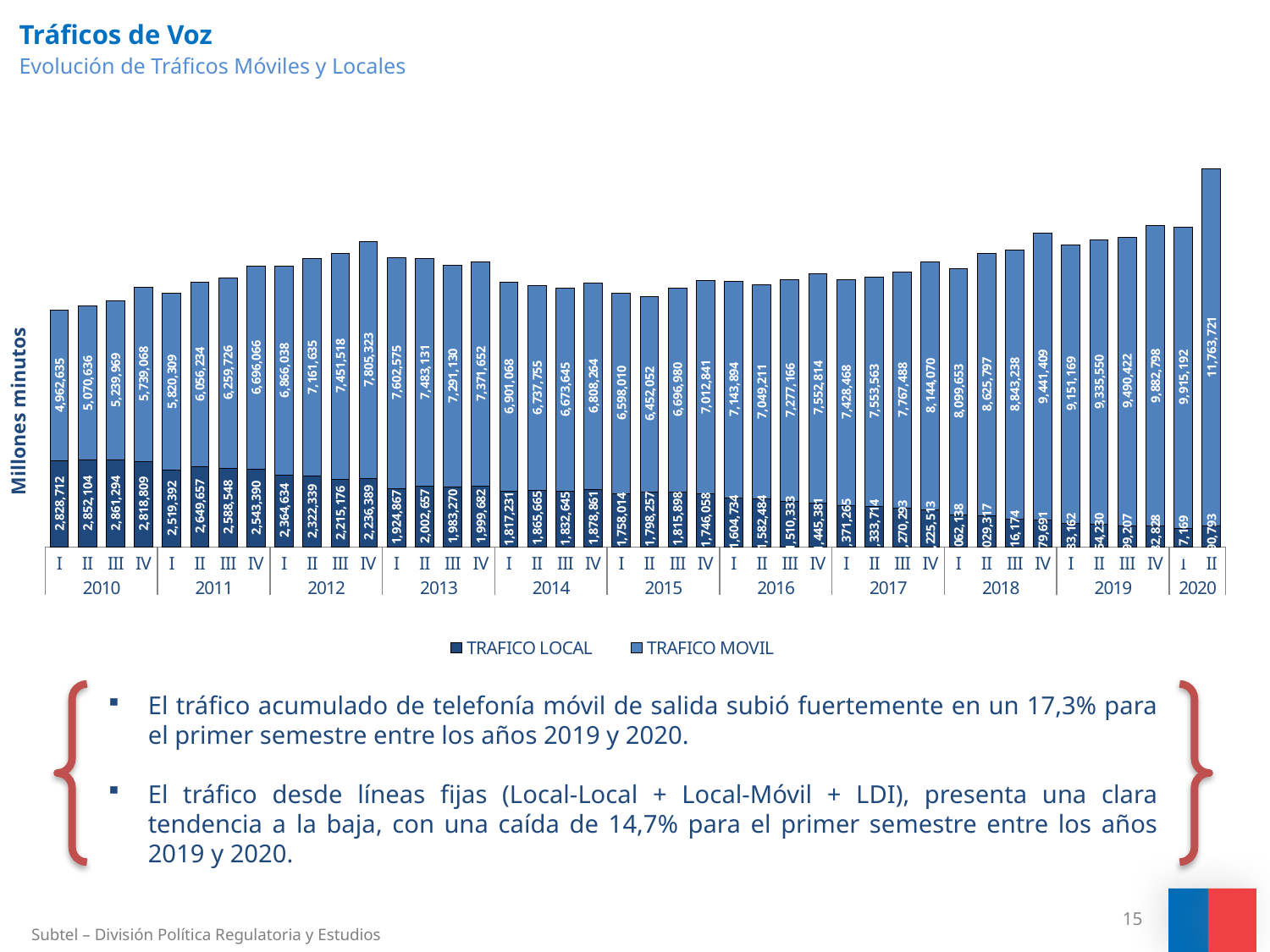
What kind of chart is shown on the slide? Stacked bar chart Does the TRAFICO LOCAL value generally rise or fall from 2010 to 2016? Fall What is the TRAFICO MOVIL value for quarter IV of 2012? 7,805,323 In which quarter is the TRAFICO MOVIL value lowest? I 2010 What is the total of the stacked bar for quarter I of 2010 (TRAFICO LOCAL plus TRAFICO MOVIL)? 7,791,347 In which quarter is the TRAFICO MOVIL value highest? II 2020 Which is larger, the TRAFICO LOCAL value for quarter I of 2010 or for quarter II of 2016? Quarter I of 2010 What is the TRAFICO LOCAL value for quarter I of 2010? 2,828,712 What is the label on the vertical axis of the chart? Millones minutos How many series does the legend list? 2 What is the TRAFICO MOVIL value for quarter II of 2020? 11,763,721 What is the difference between the TRAFICO MOVIL values for quarter II of 2020 and quarter I of 2020? 1,848,529